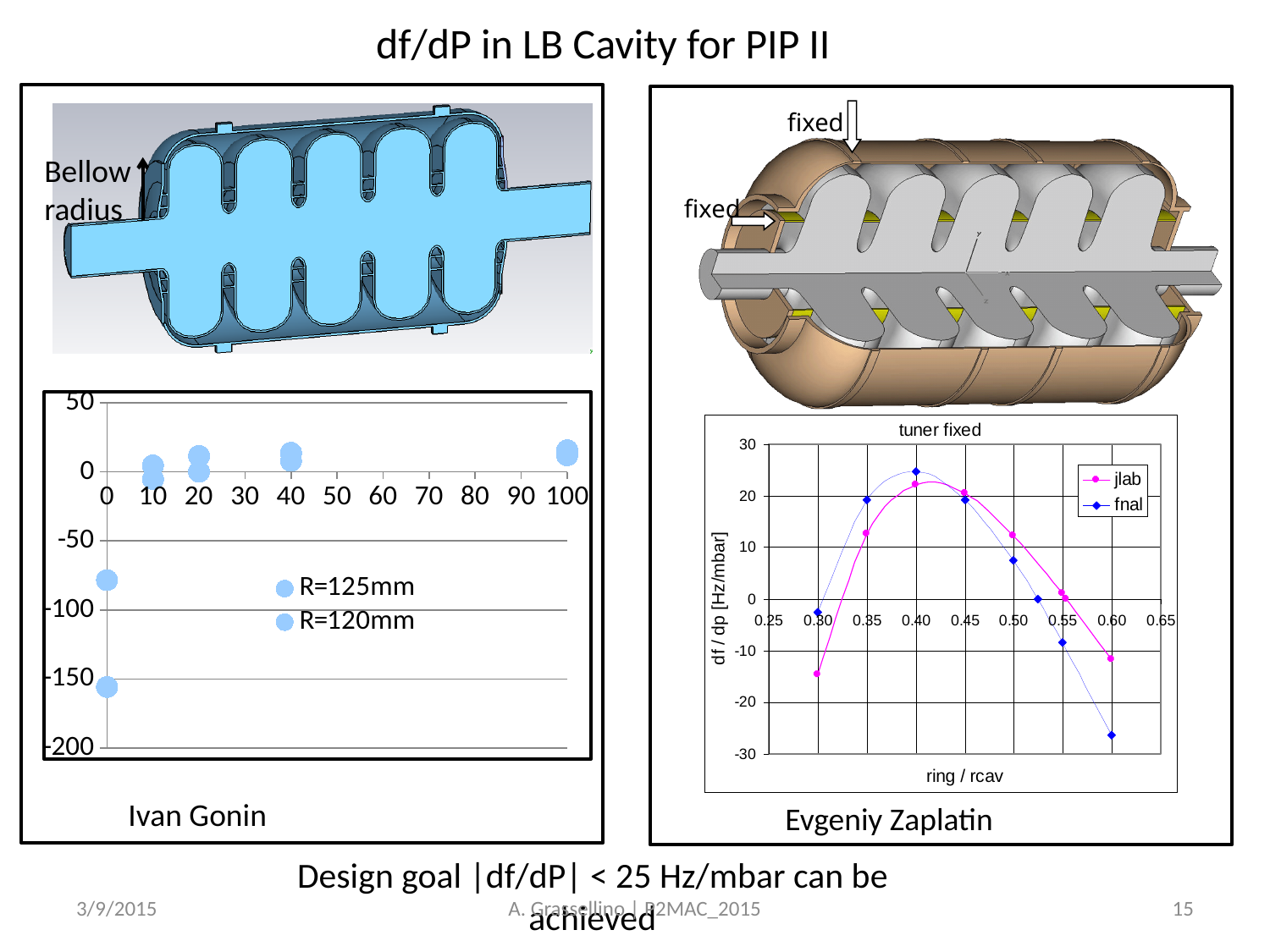
In the scatter chart on the left side of the slide, how many series does the legend list? 2 What kind of chart is the 'tuner fixed' chart? line chart In the 'tuner fixed' chart, what are the two series named in the legend? jlab and fnal In the 'tuner fixed' chart, how many series does the legend list? 2 What is the title of the chart on the right side of the slide? tuner fixed In the 'tuner fixed' chart, is the fnal value at ring/rcav = 0.40 greater or less than 20? greater In the 'tuner fixed' chart, do the jlab values rise or fall between ring/rcav = 0.45 and 0.60? fall In the 'tuner fixed' chart, which series has the larger value at ring/rcav = 0.60, jlab or fnal? jlab In the 'tuner fixed' chart, which series reaches the lowest df/dp value? fnal In the 'tuner fixed' chart, is the jlab value at ring/rcav = 0.30 greater or less than -10? less In the 'tuner fixed' chart, is the fnal value at ring/rcav = 0.60 greater or less than -20? less